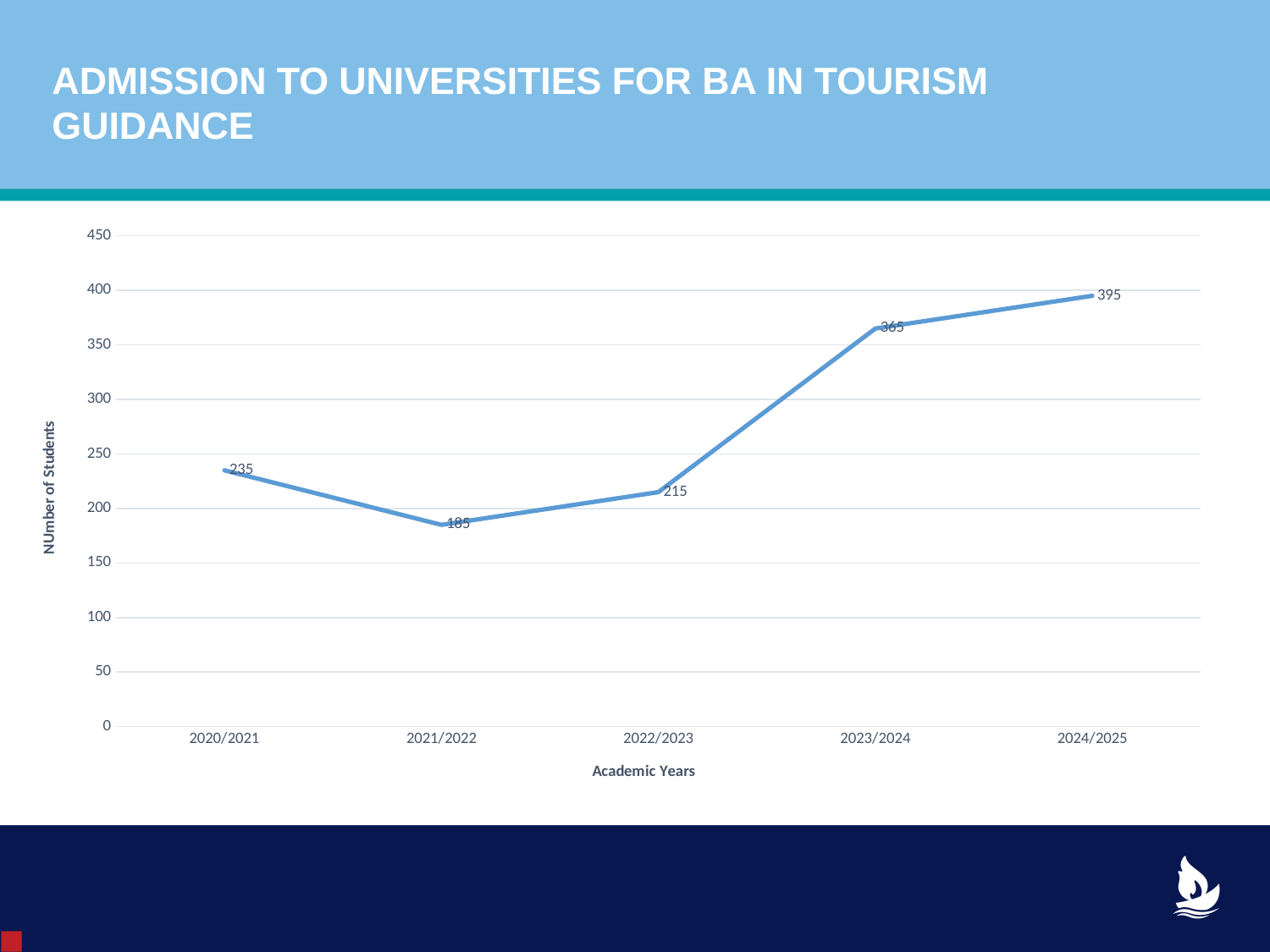
What is the number of students admitted in 2022/2023? 215 What is the difference in number of students between 2024/2025 and 2020/2021? 160 What is the number of students admitted in 2021/2022? 185 What is the number of students admitted in 2023/2024? 365 Which academic year has the highest number of students? 2024/2025 How many academic years are plotted on the chart? 5 What is the label of the vertical axis? NUmber of Students Which year has more students, 2022/2023 or 2023/2024? 2023/2024 What is the number of students admitted in 2020/2021? 235 Which academic year has the lowest number of students? 2021/2022 What kind of chart is shown on the slide? Line chart What is the number of students admitted in 2024/2025? 395